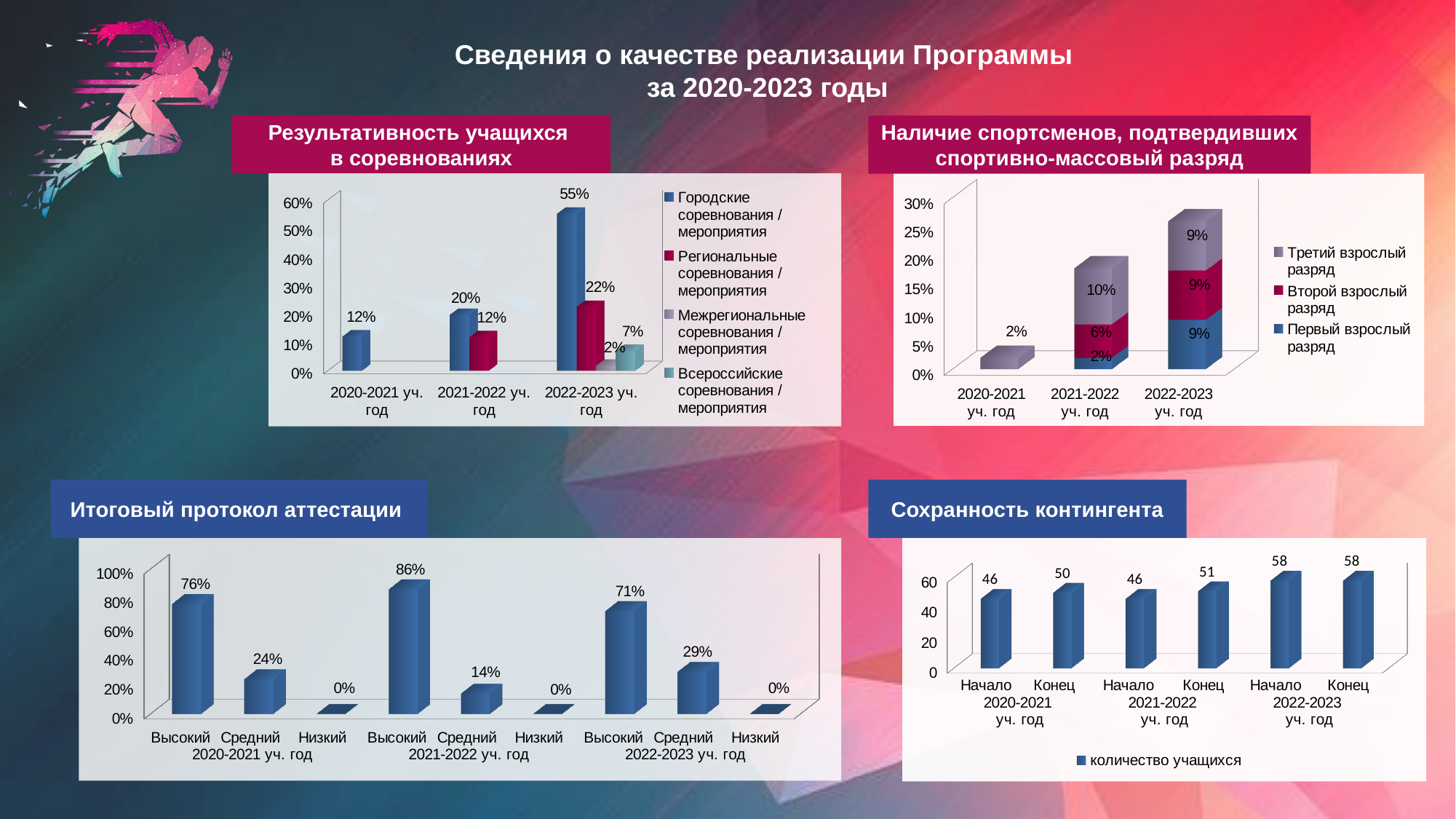
In the chart 'Сохранность контингента', what is the difference between Начало and Конец in 2020-2021 уч. год? 4 In the chart 'Результативность учащихся в соревнованиях', what is the difference between Городские and Региональные соревнования in 2021-2022 уч. год? 8% In the chart 'Итоговый протокол аттестации', which category has the highest value? Высокий 2021-2022 уч. год In the chart 'Наличие спортсменов, подтвердивших спортивно-массовый разряд', what is the value for Второй взрослый разряд in 2021-2022 уч. год? 6% In the chart 'Итоговый протокол аттестации', what is the value for Высокий in 2021-2022 уч. год? 86% In the chart 'Сохранность контингента', what is the value for Конец 2021-2022 уч. год? 51 In the chart 'Итоговый протокол аттестации', how many bars are plotted? 9 In the chart 'Наличие спортсменов, подтвердивших спортивно-массовый разряд', which year has the lowest total? 2020-2021 уч. год In the chart 'Наличие спортсменов, подтвердивших спортивно-массовый разряд', what is the total of the stacked bar for 2022-2023 уч. год? 27% In the chart 'Результативность учащихся в соревнованиях', what is the value for Городские соревнования / мероприятия in 2022-2023 уч. год? 55% In the chart 'Результативность учащихся в соревнованиях', what is the value for Всероссийские соревнования / мероприятия in 2022-2023 уч. год? 7% In the chart 'Результативность учащихся в соревнованиях', how many series does the legend list? 4